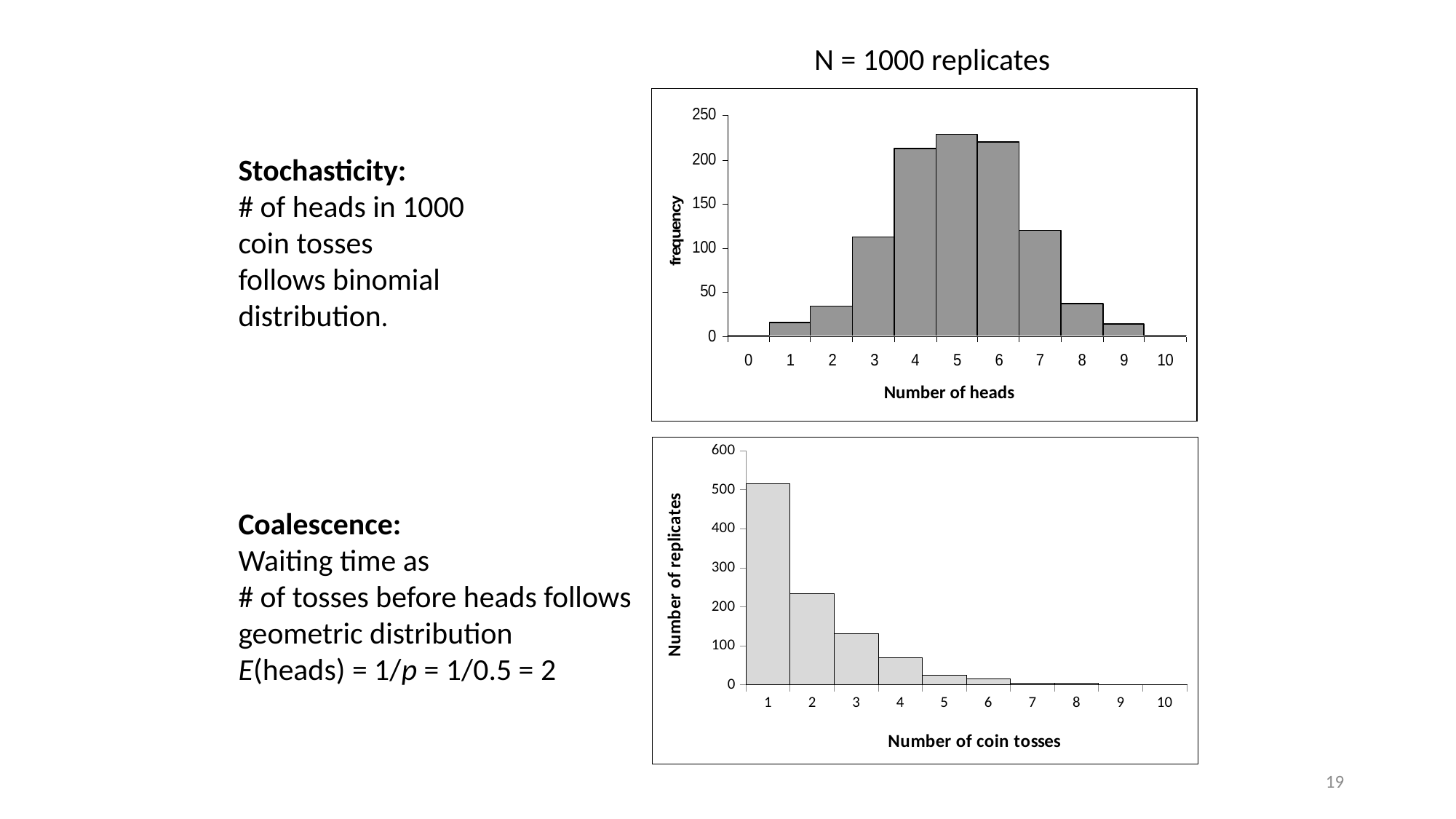
In the top chart (Number of heads), how many categories are shown on the x axis? 11 In the bottom chart (Number of coin tosses), is the number of replicates for 3 tosses greater or less than 200? less In the bottom chart (Number of coin tosses), how many categories are shown on the x axis? 10 In the top chart (Number of heads), is the frequency for 3 heads greater or less than 100? greater In the top chart (Number of heads), is the frequency for 2 heads greater or less than 50? less What is the y-axis title of the bottom chart (Number of coin tosses)? Number of replicates In the bottom chart (Number of coin tosses), which number of coin tosses has the highest number of replicates? 1 What kind of chart is the top chart titled 'N = 1000 replicates'? bar chart In the top chart (Number of heads), which has the higher frequency, 5 heads or 2 heads? 5 heads In the bottom chart (Number of coin tosses), do the values rise or fall as the number of coin tosses increases? fall